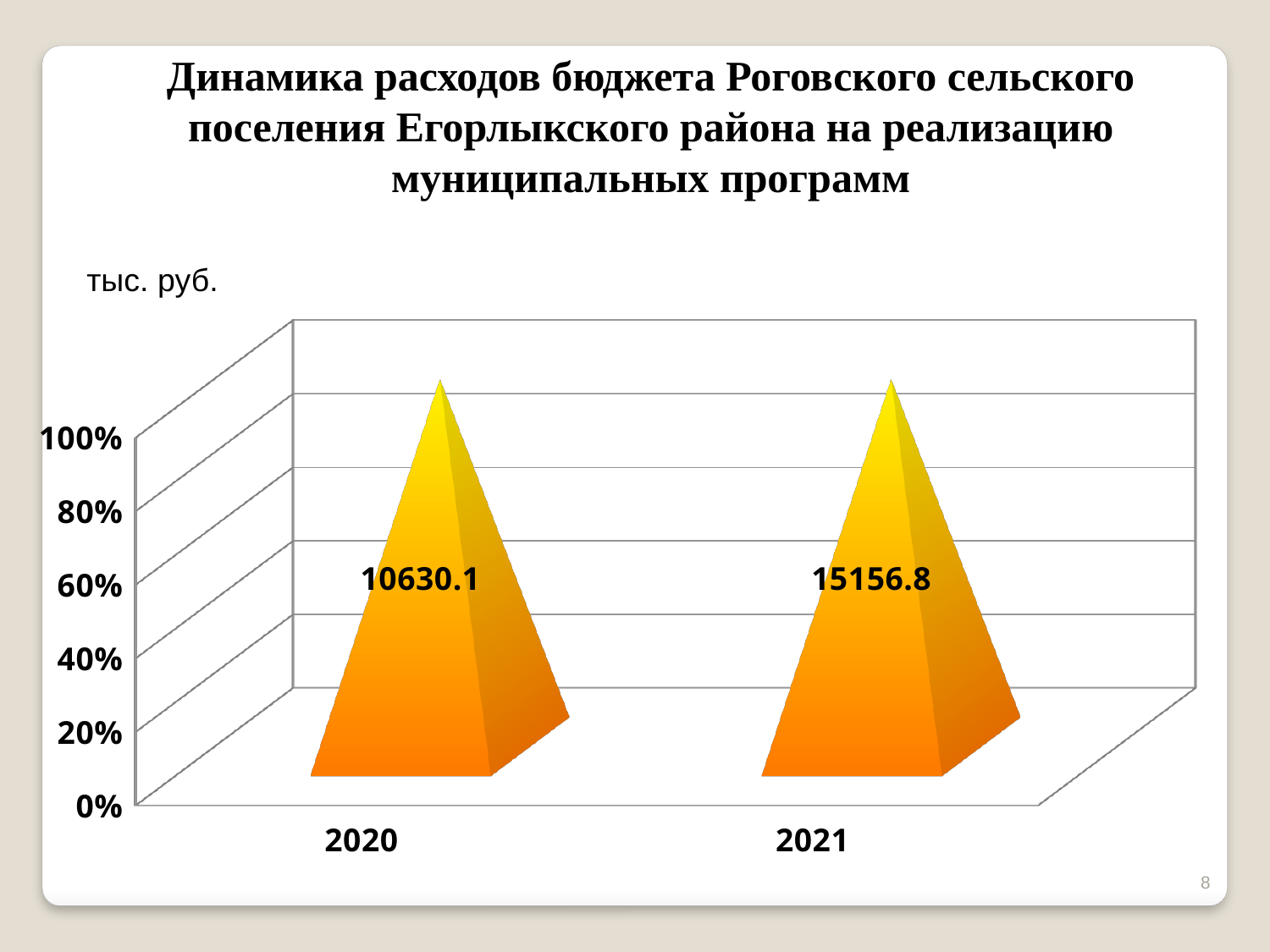
What unit of measurement is indicated above the chart? тыс. руб. How many years are shown on the x axis? 2 Do the values rise or fall from 2020 to 2021? rise Is the value for 2020 larger or smaller than the value for 2021? smaller Which year has the higher value? 2021 Which year has the lower value? 2020 What is the value shown for 2021? 15156.8 What is the value shown for 2020? 10630.1 What is the highest tick label shown on the vertical axis? 100% What kind of chart is shown on the slide? bar chart By how much does the value for 2021 exceed the value for 2020? 4526.7